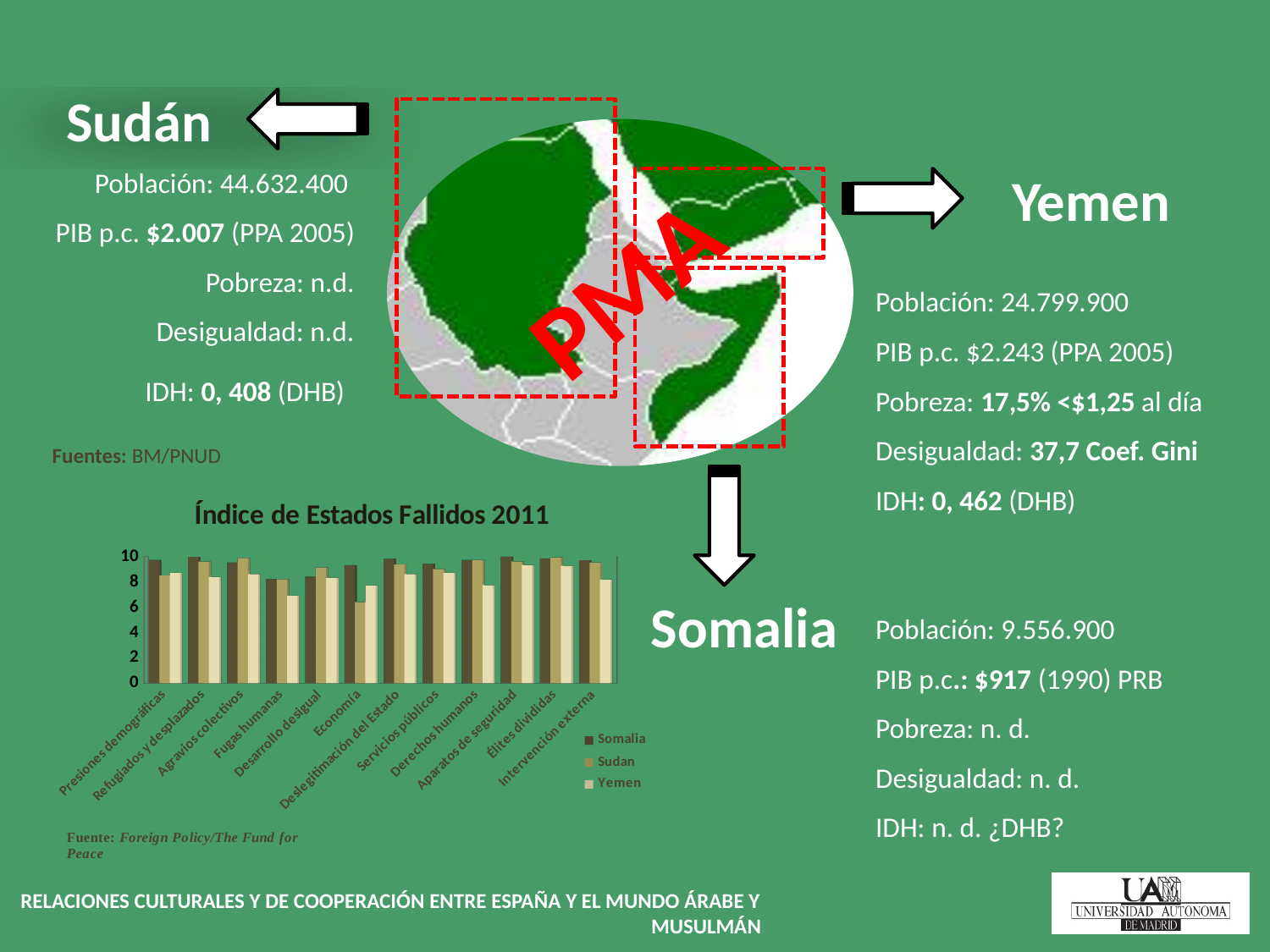
Which countries are listed in the chart's legend? Somalia, Sudan, Yemen Is the value for Somalia in the category Economía greater or less than 8? greater Is the value for Yemen in the category Fugas humanas greater or less than 8? less What is the title of the chart on the slide? Índice de Estados Fallidos 2011 In the category Economía, which is larger: the value for Somalia or the value for Sudan? Somalia What kind of chart is shown on the slide? bar chart Is the value for Somalia in the category Presiones demográficas greater or less than 8? greater In the category Fugas humanas, which is larger: the value for Somalia or the value for Yemen? Somalia How many categories are shown along the x axis of the chart? 12 For the Sudan series, which category has the lowest value? Economía How many series does the chart's legend list? 3